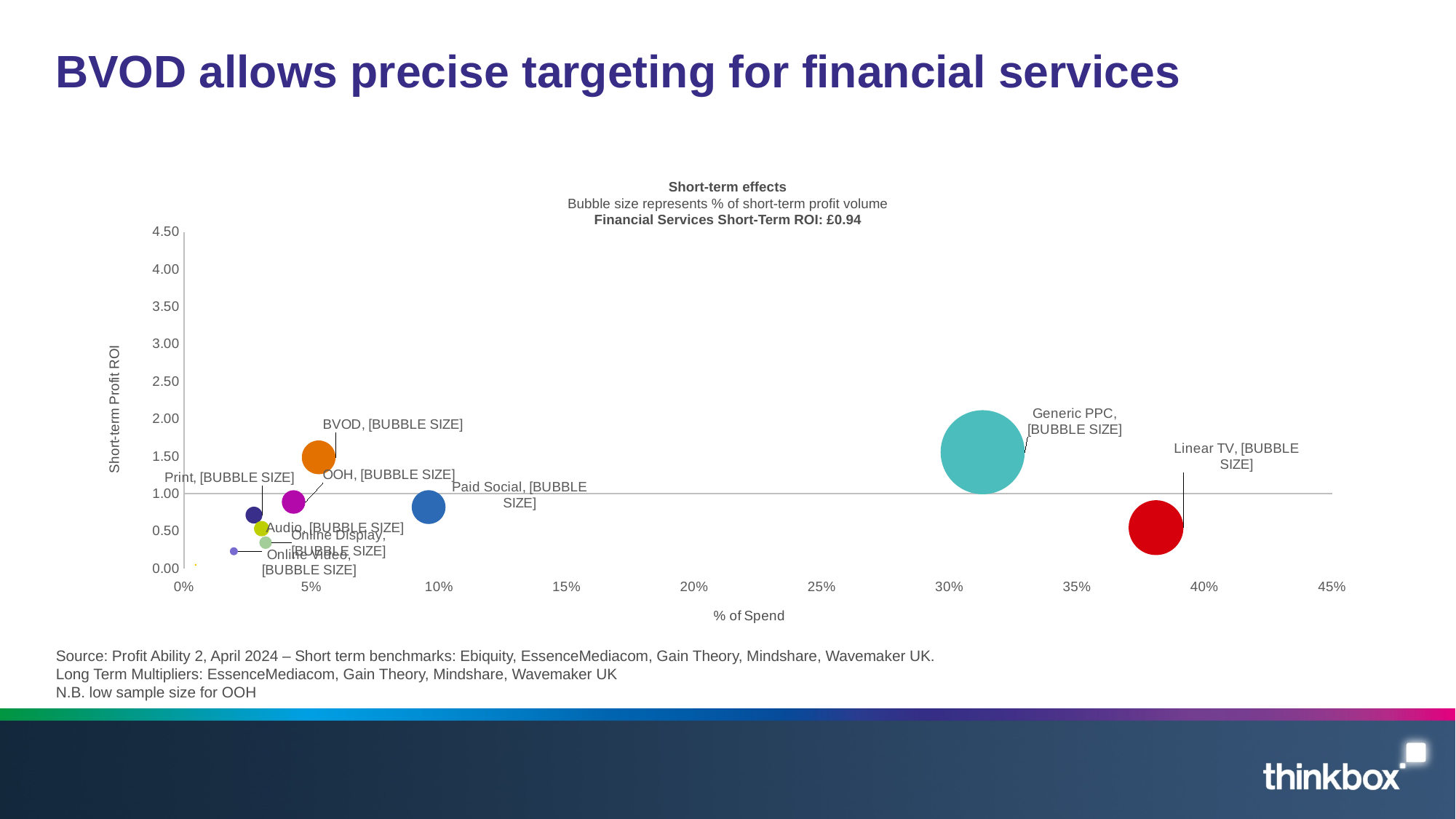
Is the % of Spend for Linear TV greater or less than 35%? greater What does the bubble size represent in the chart? % of short-term profit volume What is the title of the chart? Short-term effects Is the Short-term Profit ROI for Linear TV greater or less than 1.00? less Which media channel has the highest % of Spend? Linear TV Which has a higher Short-term Profit ROI, BVOD or Paid Social? BVOD Which media channel has the largest bubble? Generic PPC What kind of chart is shown on the slide? Bubble chart Which has a higher % of Spend, Generic PPC or Linear TV? Linear TV What Financial Services Short-Term ROI is stated in the chart heading? £0.94 Is the Short-term Profit ROI for BVOD greater or less than 1.00? greater